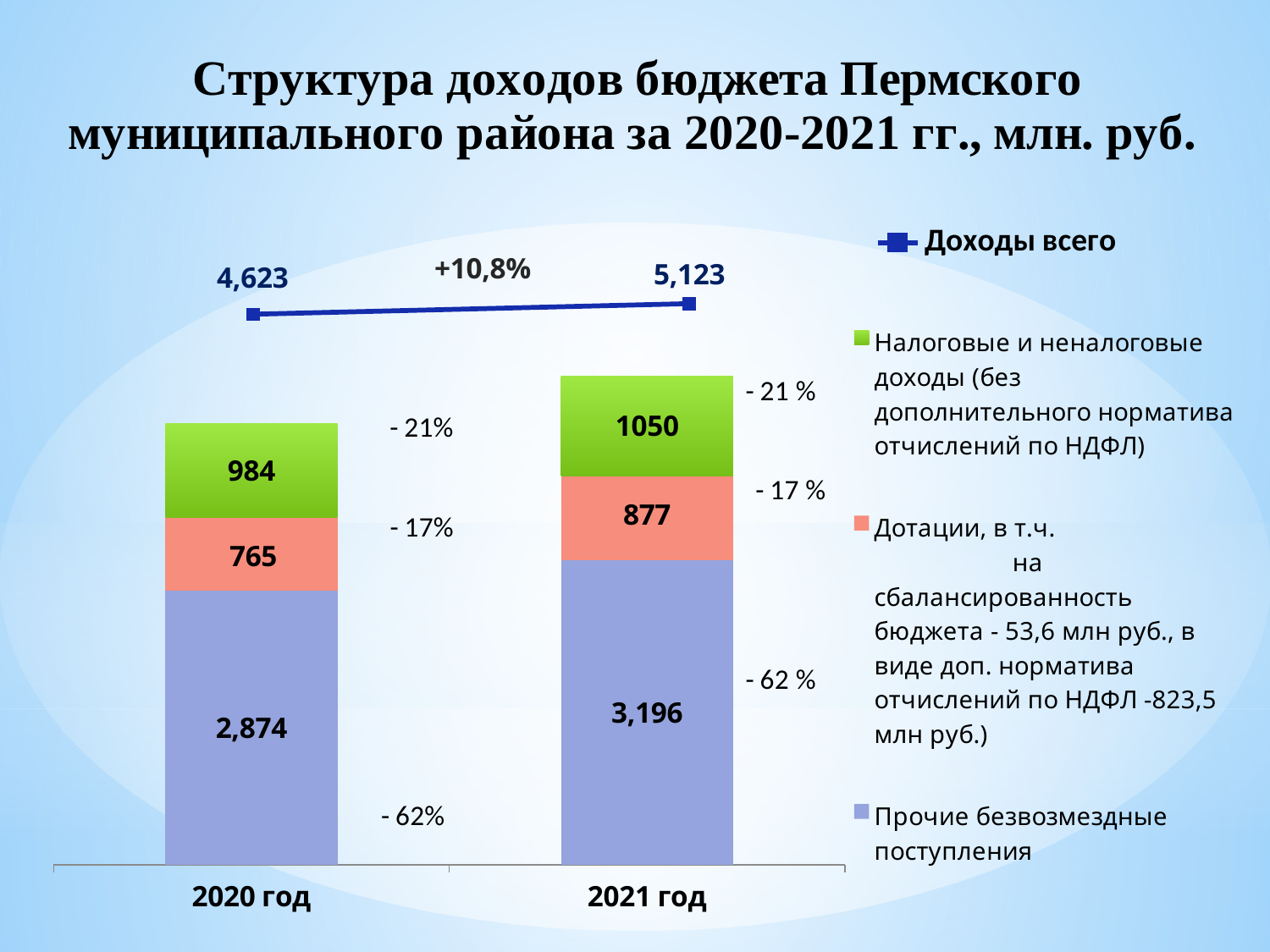
What is the value of 'Дотации' for 2020 год? 765 What is the value of 'Налоговые и неналоговые доходы' for 2021 год? 1050 What is the difference between the 'Дотации' values for 2021 год and 2020 год? 112 What is the 'Доходы всего' value for 2021 год? 5,123 How many entries does the legend list? 4 What type of chart is shown on the slide? Stacked bar chart with a line Is the 'Налоговые и неналоговые доходы' value larger for 2020 год or 2021 год? 2021 год What is the value of 'Прочие безвозмездные поступления' for 2020 год? 2,874 Which segment is the smallest in the 2021 год bar? Дотации How many years (categories) are shown on the x axis? 2 Which year has the higher 'Доходы всего' value? 2021 год What percentage change in 'Доходы всего' is shown between 2020 год and 2021 год? +10,8%